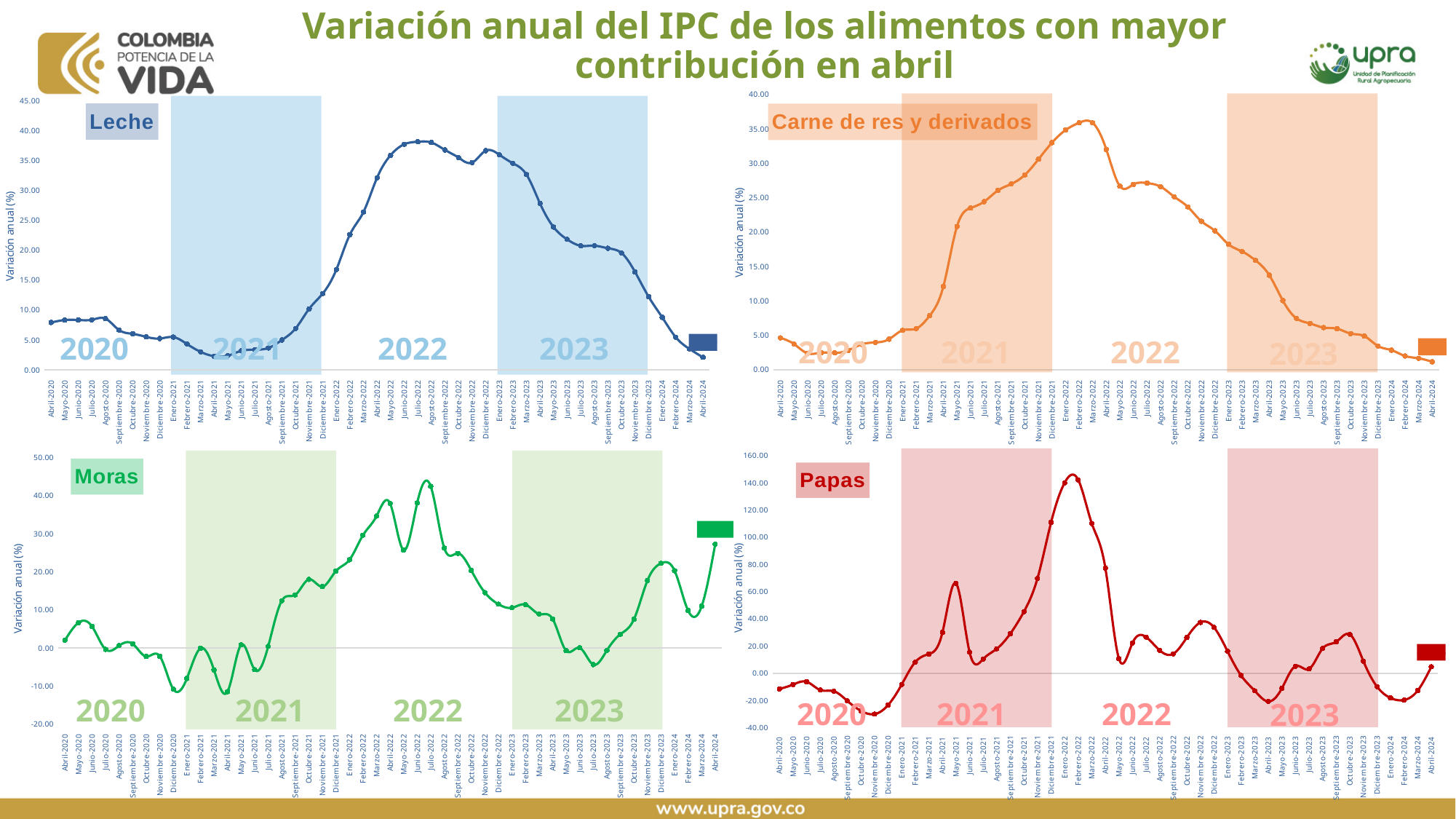
In the Carne de res y derivados chart, is the value for Abril-2024 greater or less than 5.00? less In the Papas chart, which is larger, the value for Abril-2021 or the value for Abril-2022? Abril-2022 In the Leche chart, which is larger, the value for Abril-2020 or the value for Abril-2024? Abril-2020 What kind of chart is the Leche chart? line chart In the Carne de res y derivados chart, is the value for Febrero-2022 greater or less than 30.00? greater In the Carne de res y derivados chart, do the values rise or fall from Marzo-2022 to Abril-2024? fall In the Papas chart, is the value for Febrero-2022 greater or less than 120.00? greater What is the y-axis label on the Papas chart? Variación anual (%) How many charts are shown on the slide? 4